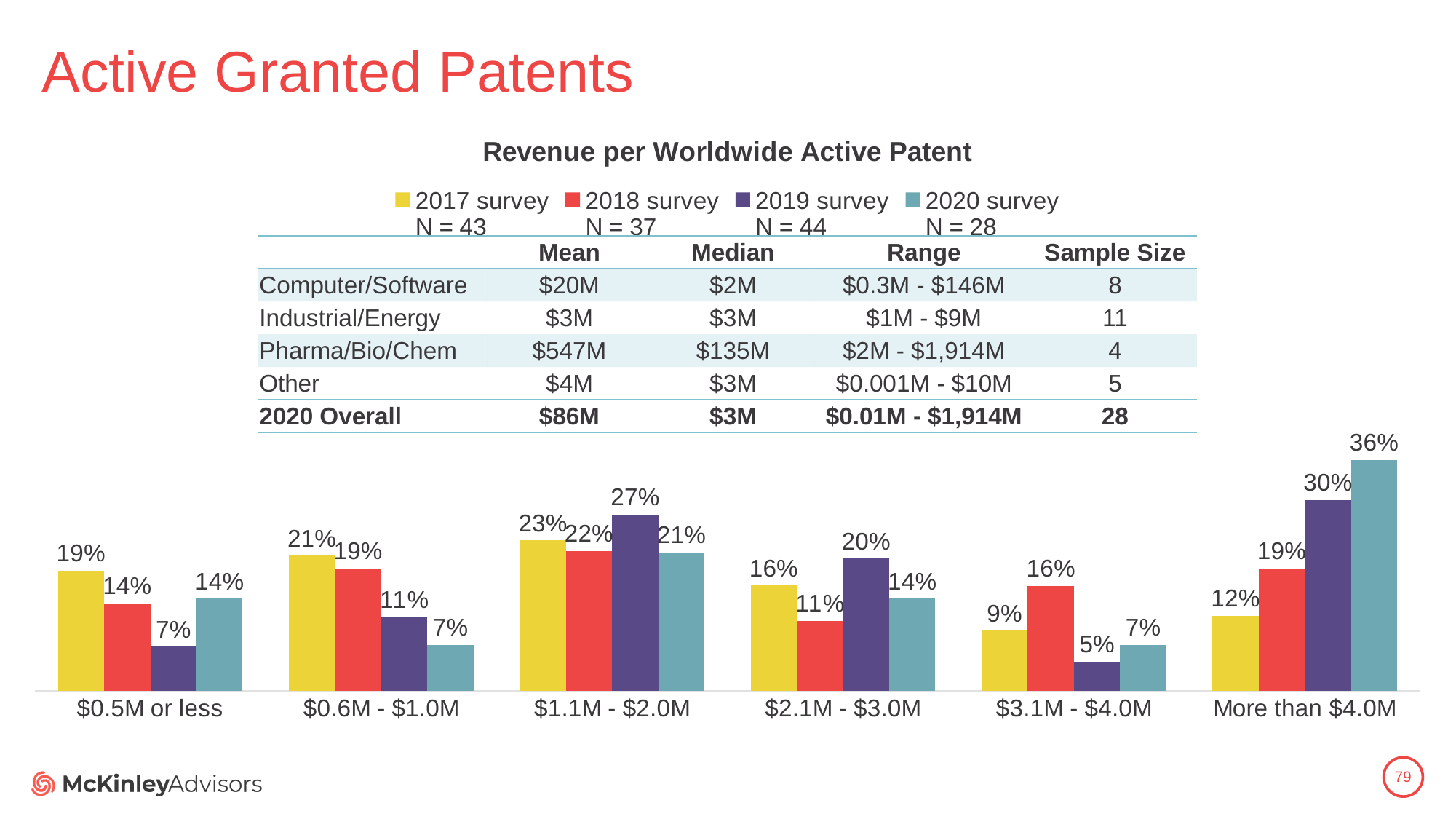
How many series does the chart legend list? 4 In the "$0.6M - $1.0M" category, which is larger: the 2017 survey value or the 2020 survey value? 2017 survey Which category has the lowest value for the 2019 survey? $3.1M - $4.0M What is the value for the 2017 survey in the "$0.5M or less" category? 19% Which category has the highest value for the 2020 survey? More than $4.0M What is the sample size (N) for the 2020 survey shown in the legend? N = 28 What is the difference between the 2020 survey and the 2017 survey values in the "More than $4.0M" category? 24% What is the value for the 2019 survey in the "$1.1M - $2.0M" category? 27% What is the value for the 2020 survey in the "More than $4.0M" category? 36% What kind of chart is shown on the slide? Bar chart How many revenue categories are shown on the x axis of the chart? 6 What is the value for the 2018 survey in the "$3.1M - $4.0M" category? 16%